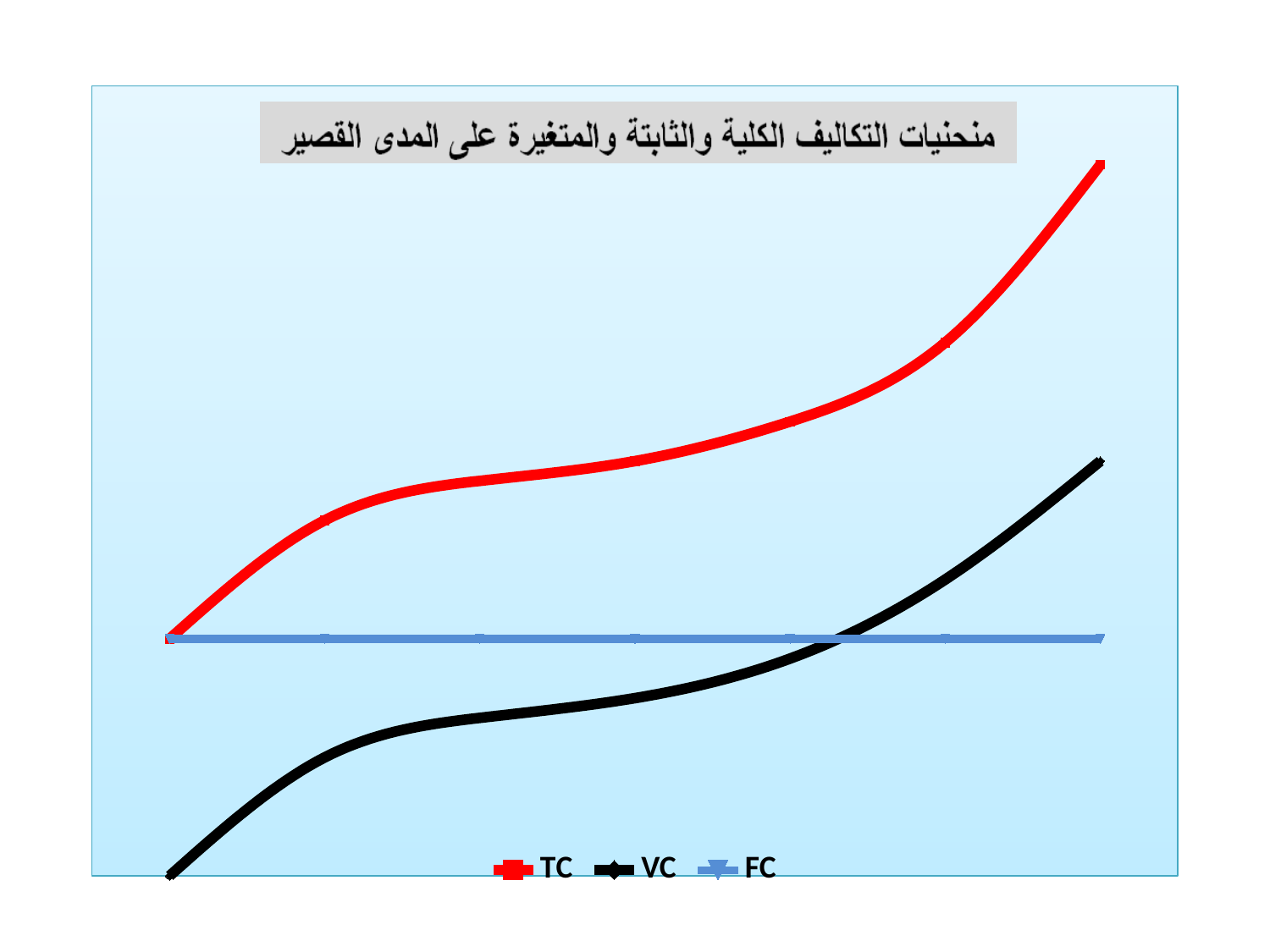
At the left end of the chart, which series is higher, FC or VC? FC Which colour is used for the TC series? Red Which series starts at the lowest point on the left side of the chart? VC Which series is the highest across the whole chart? TC Does the TC curve rise or fall as you move from left to right along the x axis? Rises What kind of chart is shown on the slide? Line chart Does the VC curve rise or fall as you move from left to right along the x axis? Rises What are the names of the series listed in the legend? TC, VC, FC How many series does the legend list? 3 At the right end of the chart, which series is higher, TC or VC? TC Does the FC line rise, fall, or stay flat along the x axis? Stays flat